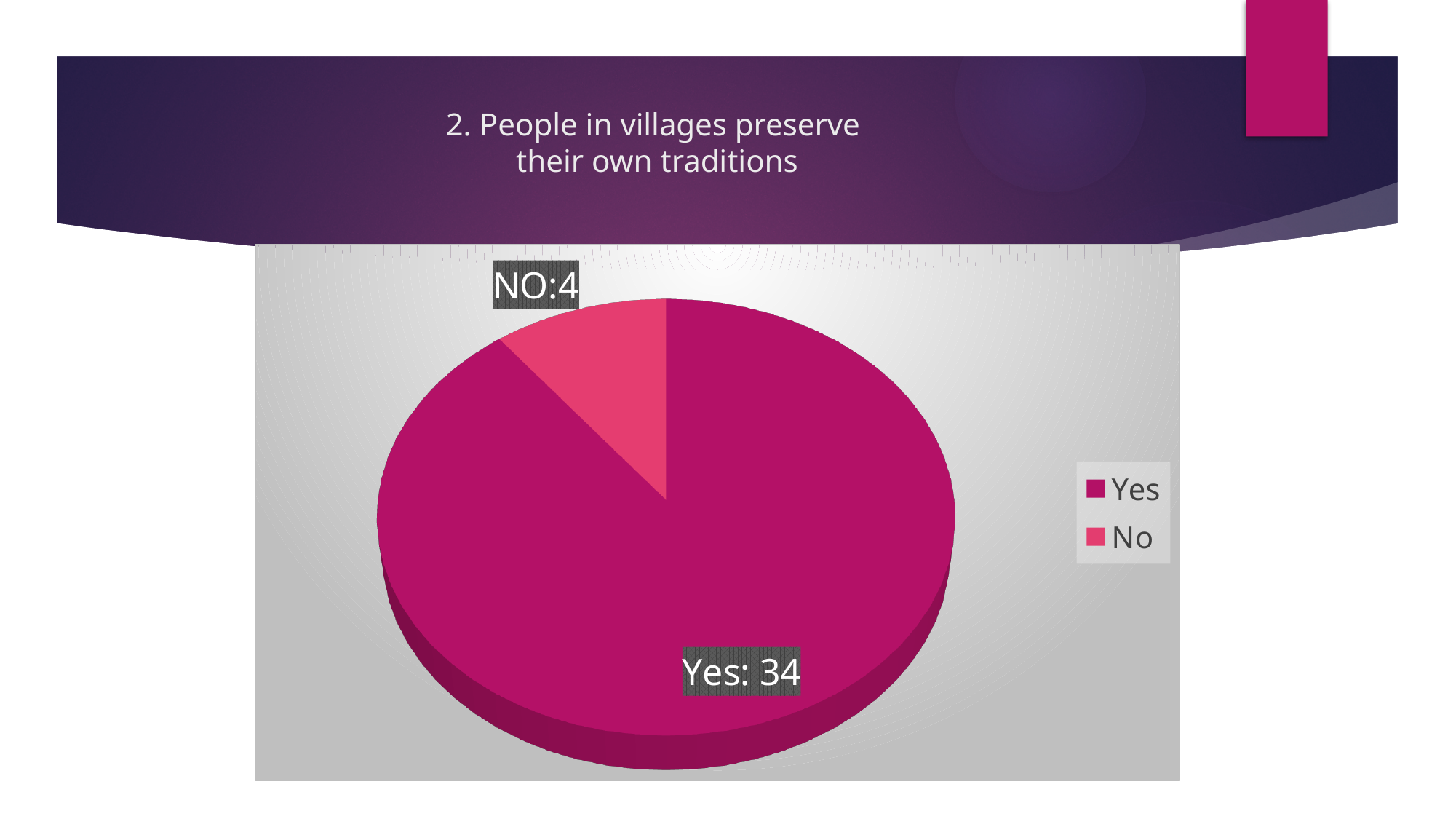
Which is larger, the Yes count or the No count? Yes How many people answered No? 4 What is the title of the slide above the chart? 2. People in villages preserve their own traditions What kind of chart is shown on the slide? pie chart What is the difference between the number of Yes and No responses? 30 What is the total number of responses shown in the pie chart? 38 Which response has the smallest slice of the pie? No How many people answered Yes? 34 Which response has the largest slice of the pie? Yes How many slices does the pie chart have? 2 How many entries does the legend list? 2 Which legend entry is shown in the lighter pink colour? No